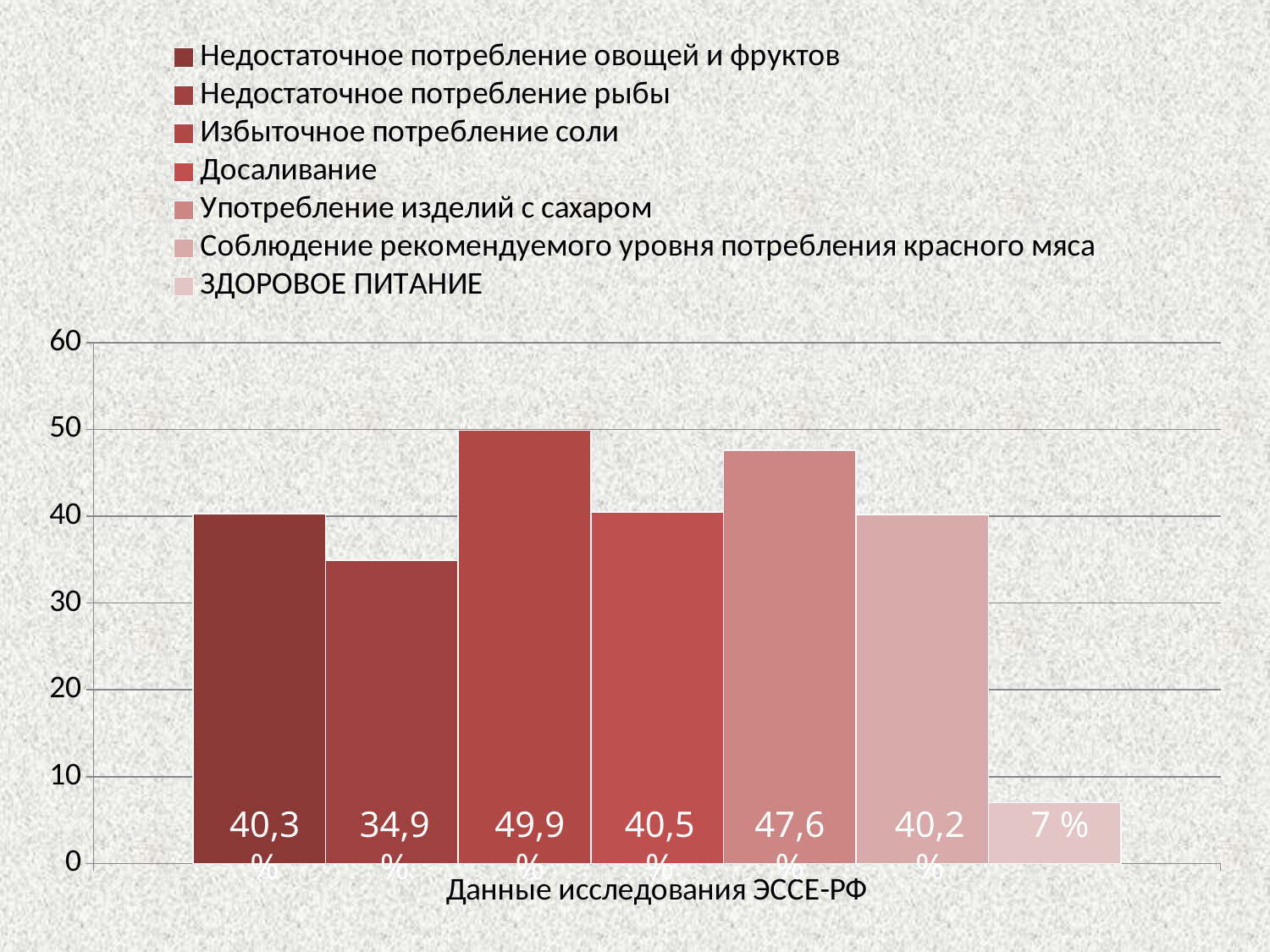
What is the value for ЗДОРОВОЕ ПИТАНИЕ? 7 % What is the difference between the values for Избыточное потребление соли and Недостаточное потребление рыбы? 15 % Which series has the lowest value? ЗДОРОВОЕ ПИТАНИЕ What is the value for Избыточное потребление соли? 49,9 % What is the value for Недостаточное потребление рыбы? 34,9 % Which is larger: the value for Досаливание or the value for Недостаточное потребление рыбы? Досаливание Which series has the highest value? Избыточное потребление соли What kind of chart is shown on the slide? bar chart What is the value for Употребление изделий с сахаром? 47,6 % What is the value for Недостаточное потребление овощей и фруктов? 40,3 % How many series does the legend list? 7 Is the value for Употребление изделий с сахаром greater or less than 40? greater